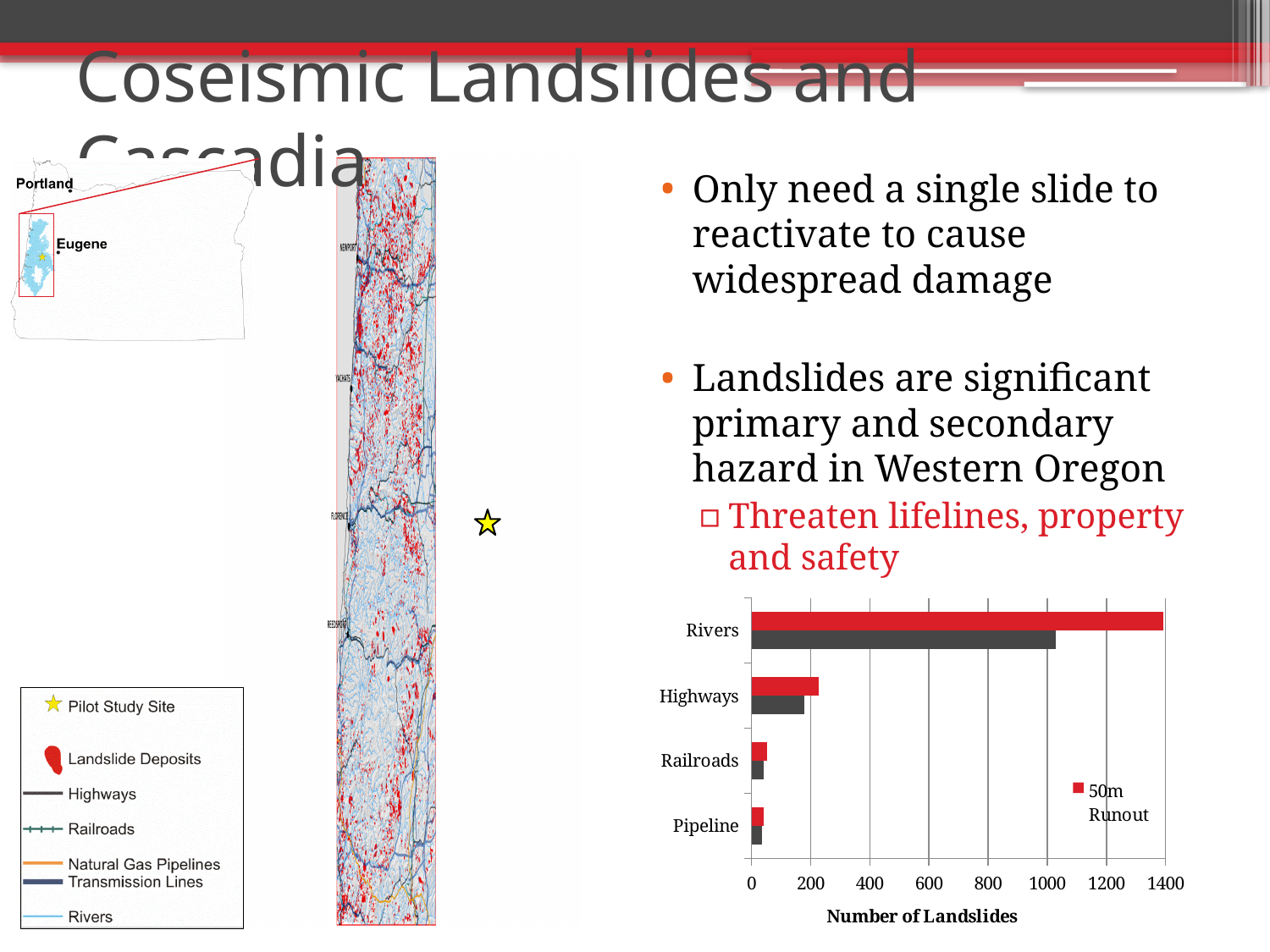
Is the 50m Runout value for Highways greater or less than 400? less Which has more landslides in the 50m Runout series, Rivers or Highways? Rivers What is the maximum value shown on the horizontal axis of the bar chart? 1400 Is the 50m Runout value for Railroads greater or less than 200? less Which has more landslides in the 50m Runout series, Highways or Railroads? Highways Which category has the highest number of landslides in the bar chart? Rivers What series name is shown in the legend of the bar chart? 50m Runout Is the 50m Runout value for Rivers greater or less than 1000? greater What is the title of the horizontal axis of the bar chart? Number of Landslides What kind of chart is shown at the bottom right of the slide? Bar chart How many categories are plotted on the 'Number of Landslides' bar chart? 4